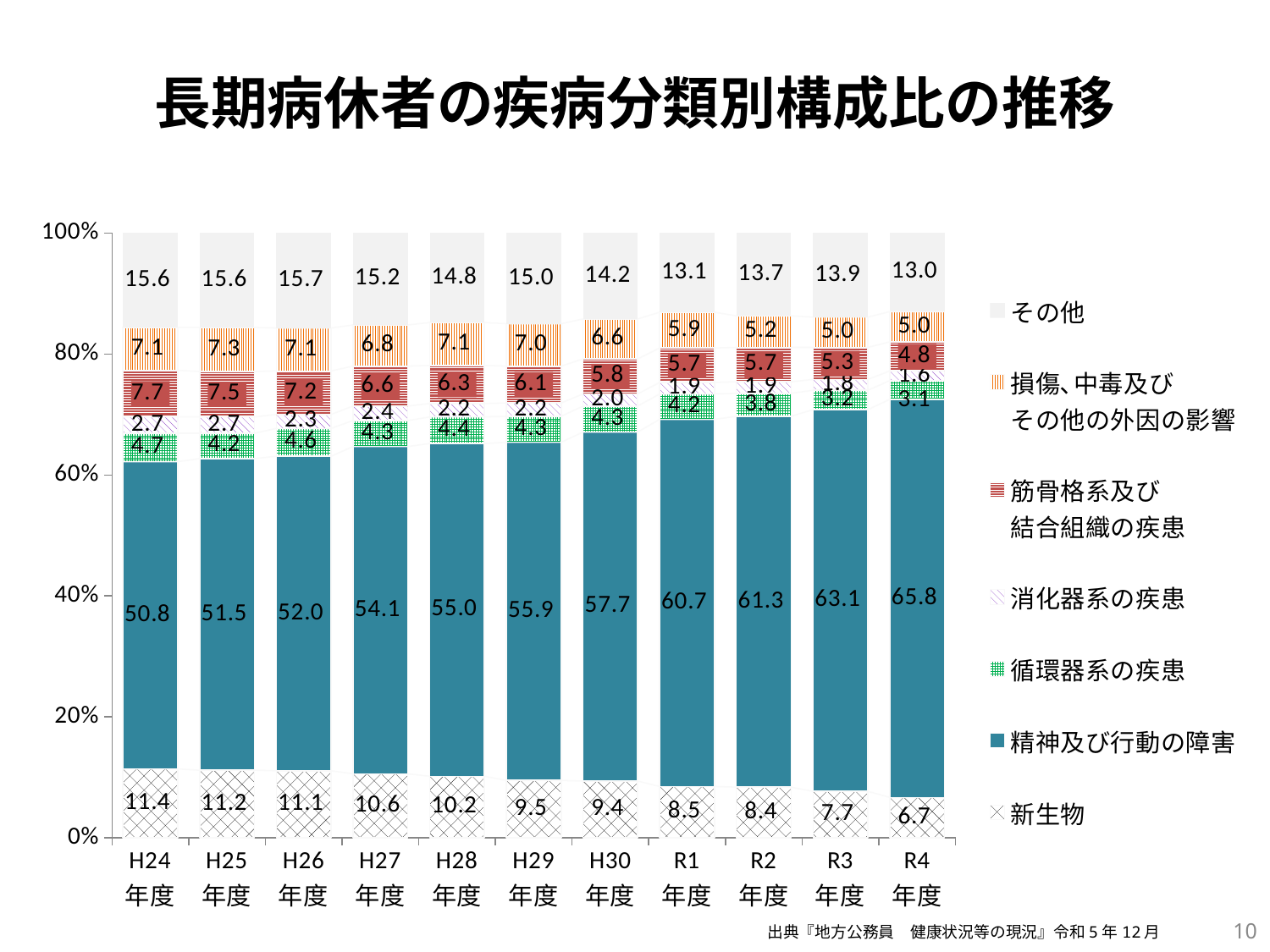
Which is larger in H25年度: 損傷、中毒及びその他の外因の影響 or 筋骨格系及び結合組織の疾患? 筋骨格系及び結合組織の疾患 Does the value for 精神及び行動の障害 rise or fall from H24年度 to R4年度? rise What kind of chart is shown on the slide? stacked bar chart How many years (categories) are shown on the x axis? 11 In which year is the value for 精神及び行動の障害 the highest? R4年度 What is the difference between the 精神及び行動の障害 values for R4年度 and H24年度? 15.0 What is the value for 新生物 in H24年度? 11.4 What is the value for 筋骨格系及び結合組織の疾患 in H30年度? 5.8 What is the value for 精神及び行動の障害 in R4年度? 65.8 What is the value for その他 in H26年度? 15.7 In which year is the value for 新生物 the lowest? R4年度 How many series does the legend list? 7